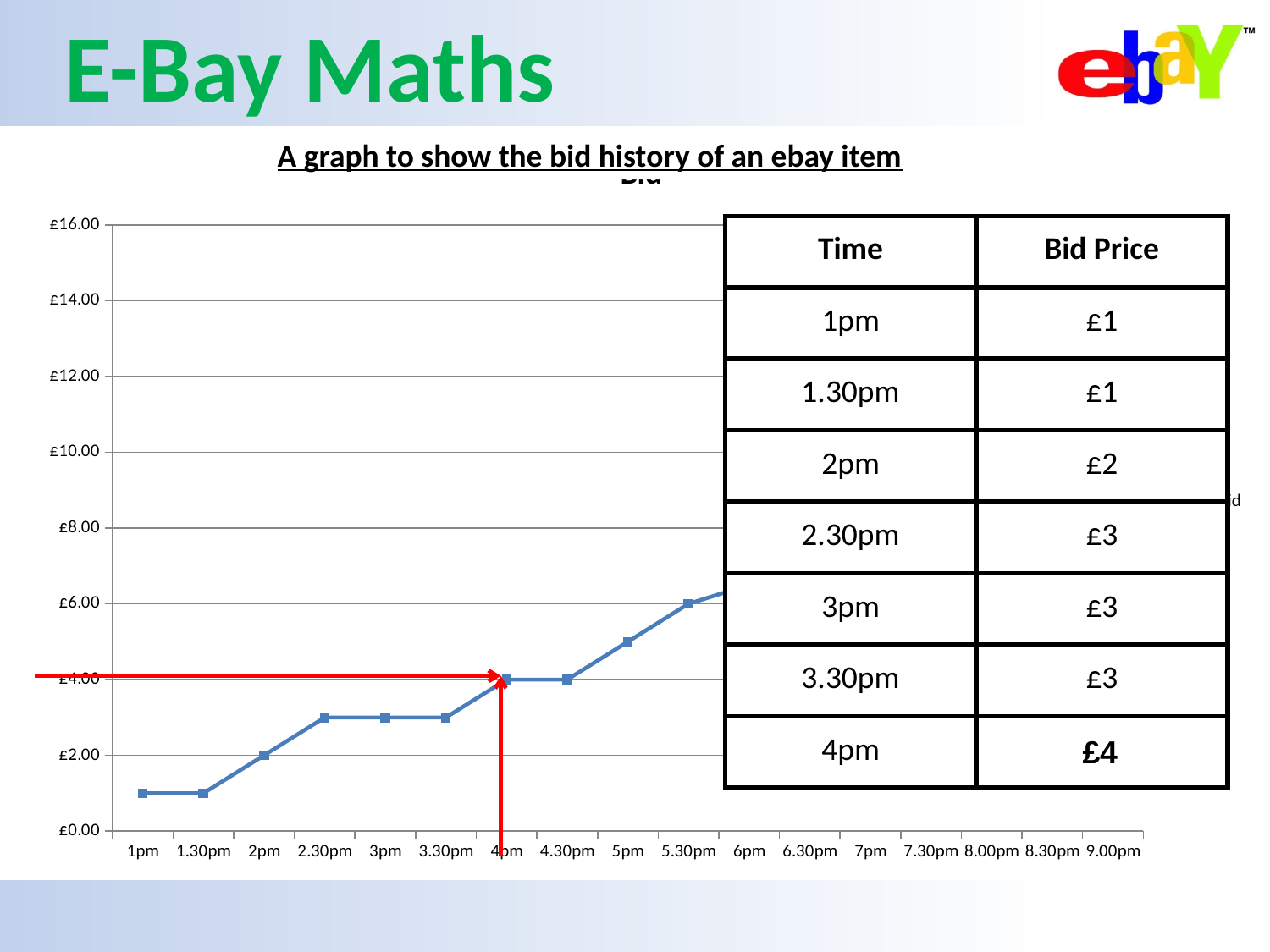
Is the value for 3pm greater or less than £4.00? less According to the table, what is the bid price at 2.30pm? £3 What is the difference between the value at 4pm and the value at 2pm? £2.00 Do the plotted values rise or fall from 1pm to 6pm? rise Which is larger, the value at 5.30pm or the value at 2pm? 5.30pm What is the title of the graph? A graph to show the bid history of an ebay item Is the value for 5pm greater or less than £4.00? greater What value does the plotted point at 5.30pm land on? £6.00 How many time labels are shown on the x axis? 17 What kind of chart is shown on the slide? line chart What value does the plotted point at 4pm land on? £4.00 What value does the plotted point at 2pm land on? £2.00